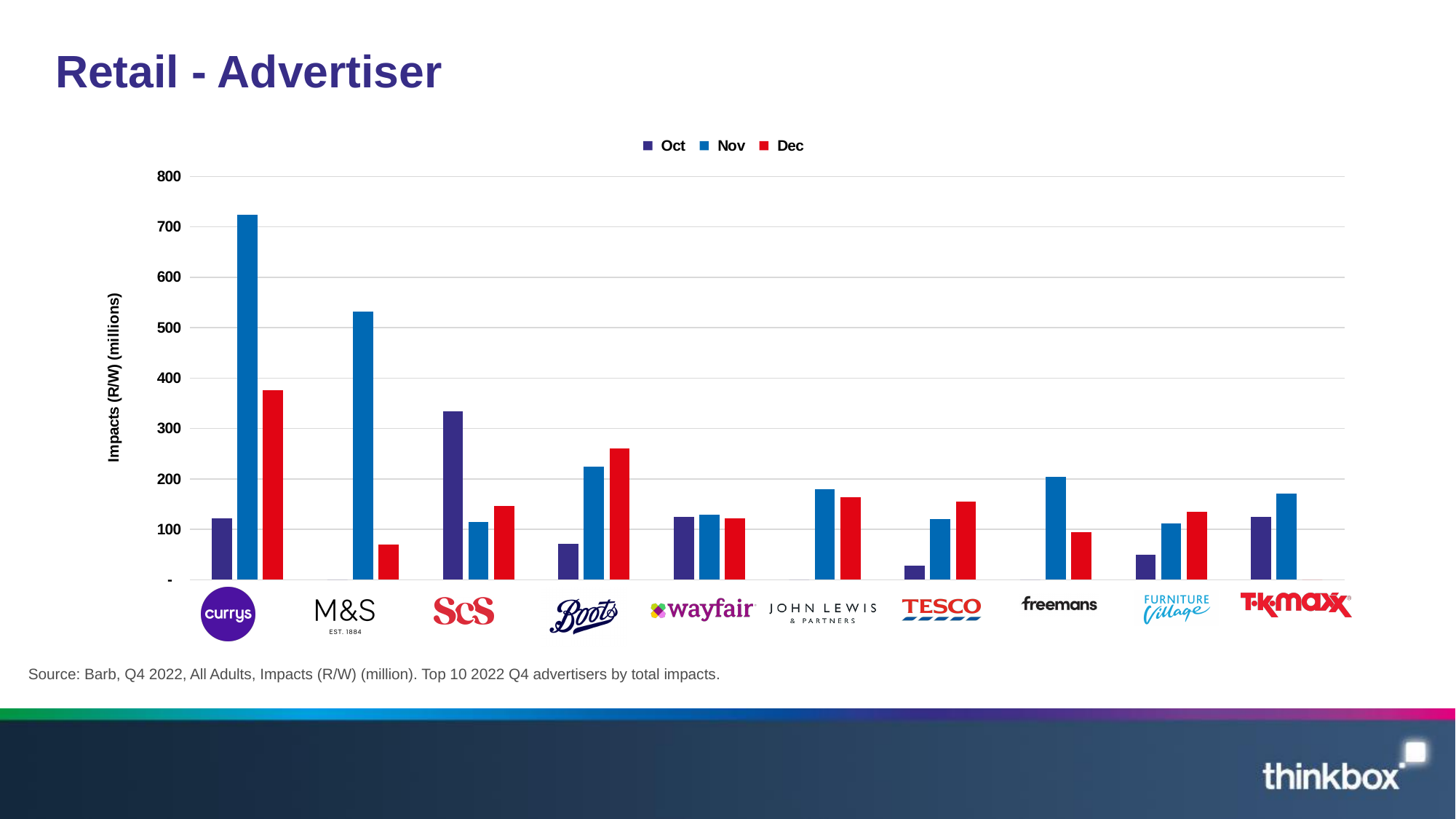
How many advertisers are shown along the x axis? 10 Is the Dec value for Currys greater or less than 300? greater Is the Oct value for ScS greater or less than 300? greater Which advertiser has the highest Oct bar? ScS Is the Nov value for Currys greater or less than 700? greater For ScS, which is larger: the Oct value or the Nov value? Oct What is the label on the y axis? Impacts (R/W) (millions) What kind of chart is shown on the slide? bar chart Which advertiser has the highest Nov bar? Currys How many series does the legend list? 3 For Boots, which is larger: the Nov value or the Dec value? Dec